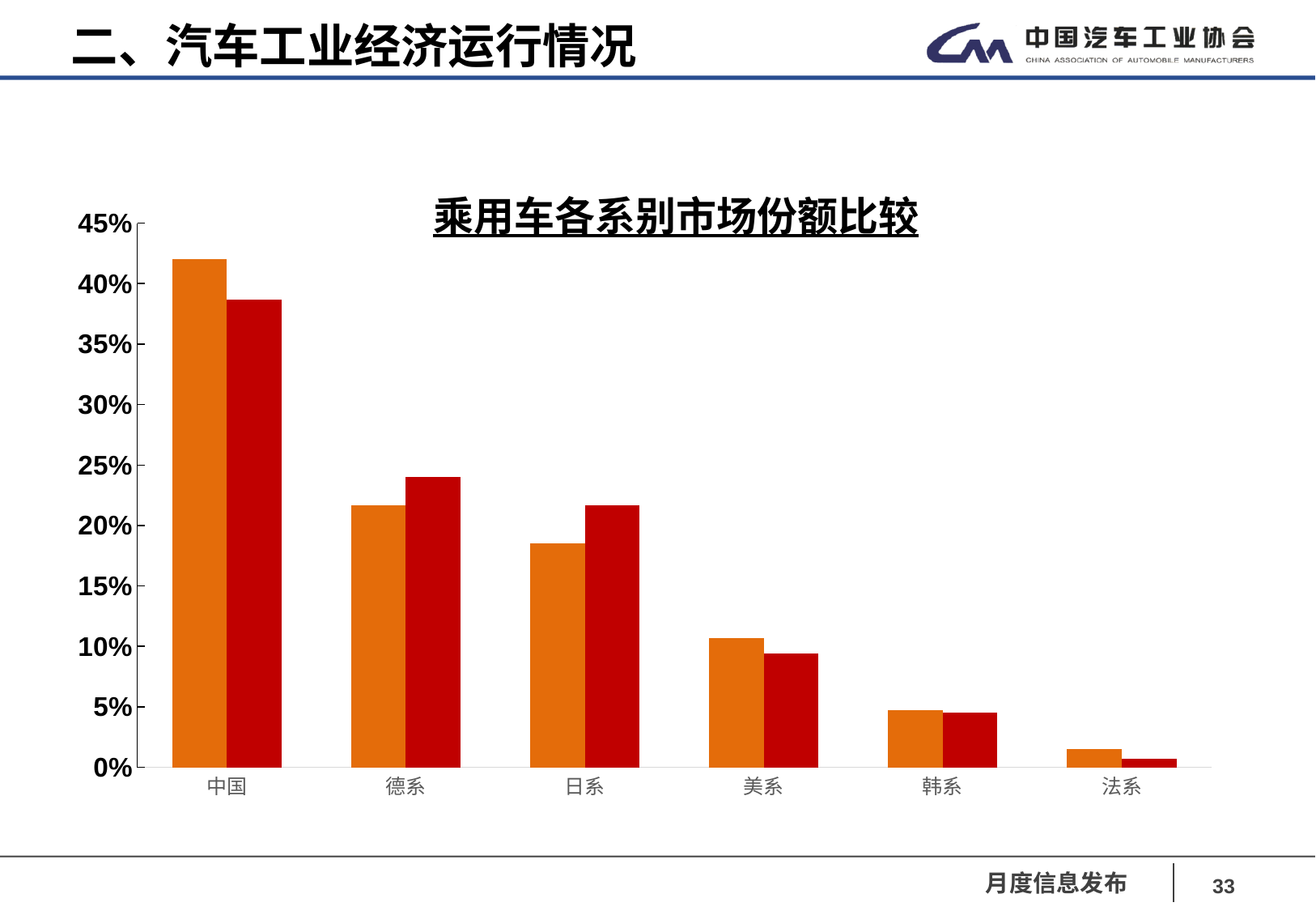
Which category has the lowest red bar in the chart? 法系 Which category has the highest orange bar in the chart? 中国 How many bars are plotted for each category in the chart? 2 What is the title of the chart? 乘用车各系别市场份额比较 For 日系, which bar is taller, the orange bar or the red bar? the red bar Is the red bar for 中国 greater or less than 40%? less What kind of chart is shown on the slide? bar chart For 美系, which bar is taller, the orange bar or the red bar? the orange bar Do the orange bars generally rise or fall moving from 中国 to 法系 along the x axis? fall How many categories are shown on the x axis of the chart? 6 Is the orange bar for 中国 greater or less than 40%? greater Is the red bar for 德系 greater or less than 20%? greater